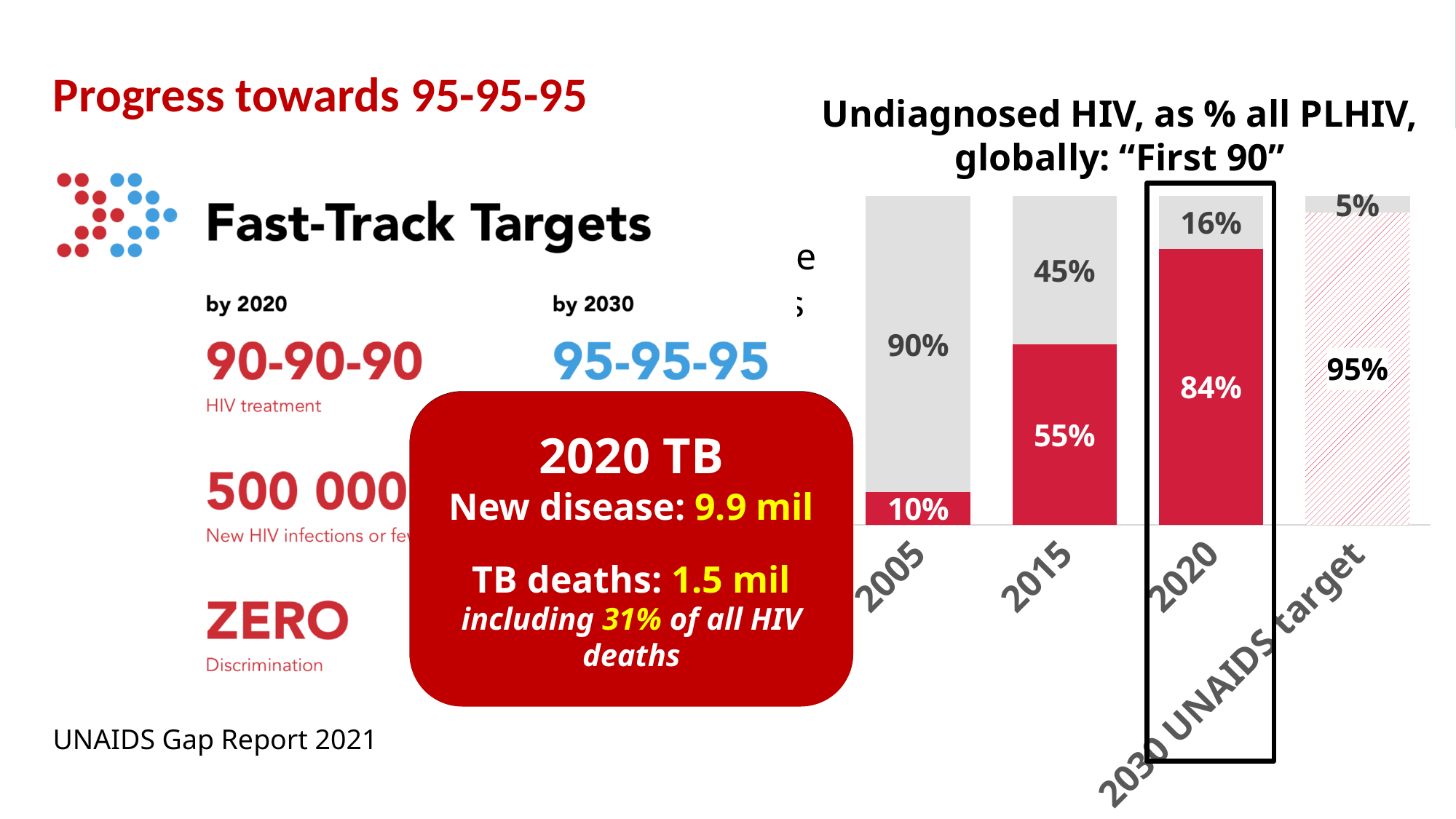
What is the difference between the red values for 2020 and 2015? 29% What is the red (diagnosed) value for 2015? 55% Do the red (diagnosed) values rise or fall from 2005 to the 2030 UNAIDS target? rise What type of chart is shown on the slide? stacked bar chart How many bars (categories) are shown in the chart? 4 What is the red value for the 2030 UNAIDS target bar? 95% Which category has the highest grey (undiagnosed) value? 2005 Is the grey (undiagnosed) value larger for 2015 or for 2020? 2015 Which category has the lowest red (diagnosed) value? 2005 What is the grey (undiagnosed) value for 2020? 16% What is the grey (undiagnosed) value for 2005? 90% What is the title of the chart on the slide? Undiagnosed HIV, as % all PLHIV, globally: "First 90"